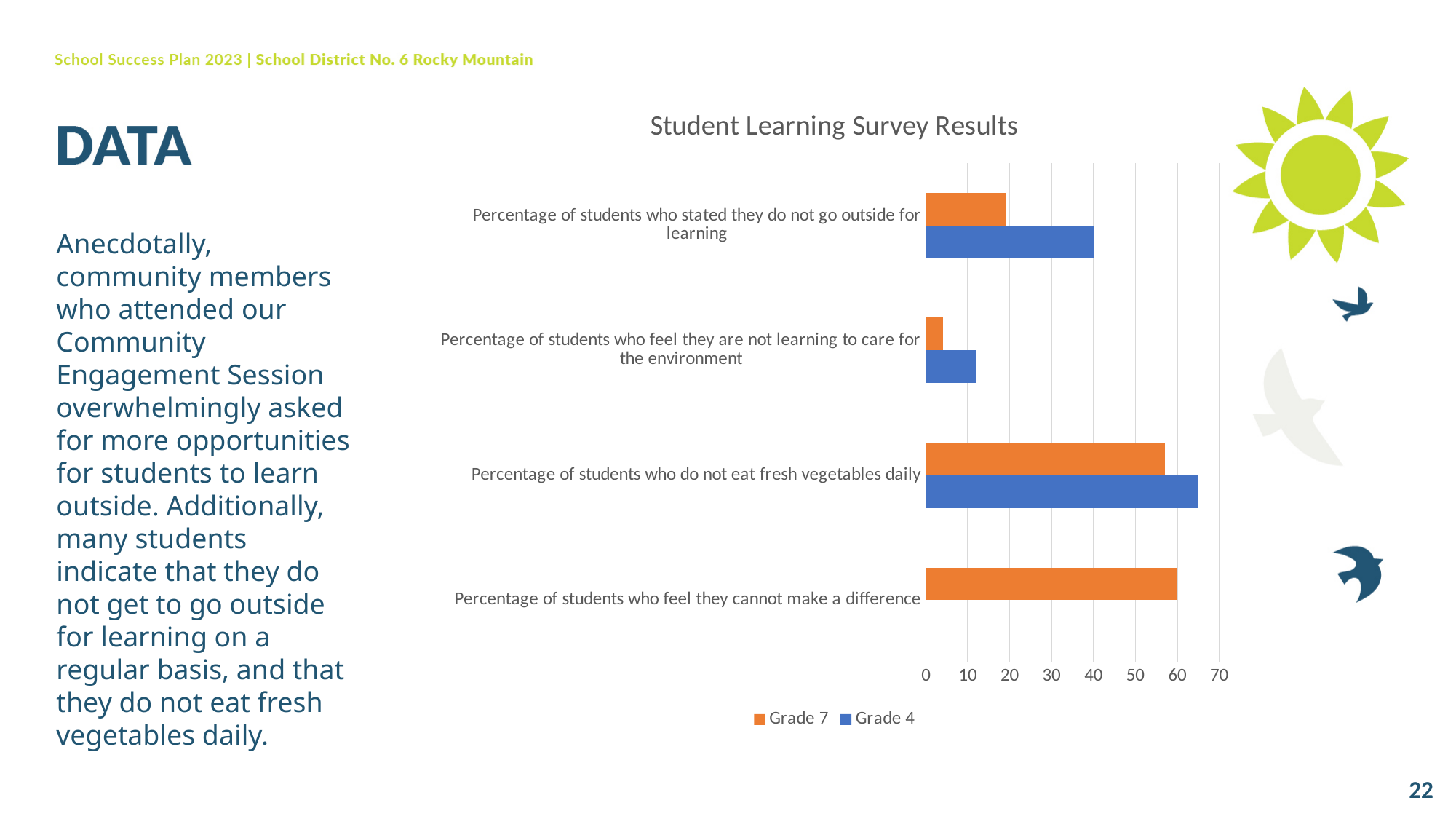
What is the title of the chart? Student Learning Survey Results Which series is shown in orange? Grade 7 Which category has the highest Grade 4 value? Percentage of students who do not eat fresh vegetables daily Is the Grade 7 value for 'Percentage of students who stated they do not go outside for learning' greater or less than 30? less Is the Grade 4 value for 'Percentage of students who feel they are not learning to care for the environment' greater or less than 20? less What type of chart is shown on the slide? Bar chart For 'Percentage of students who stated they do not go outside for learning', which is larger, the Grade 7 value or the Grade 4 value? Grade 4 Which category has the lowest Grade 7 value? Percentage of students who feel they are not learning to care for the environment How many series does the legend list? 2 How many categories are shown on the chart? 4 Which category has no Grade 4 bar shown? Percentage of students who feel they cannot make a difference Is the Grade 4 value for 'Percentage of students who do not eat fresh vegetables daily' greater or less than 60? greater